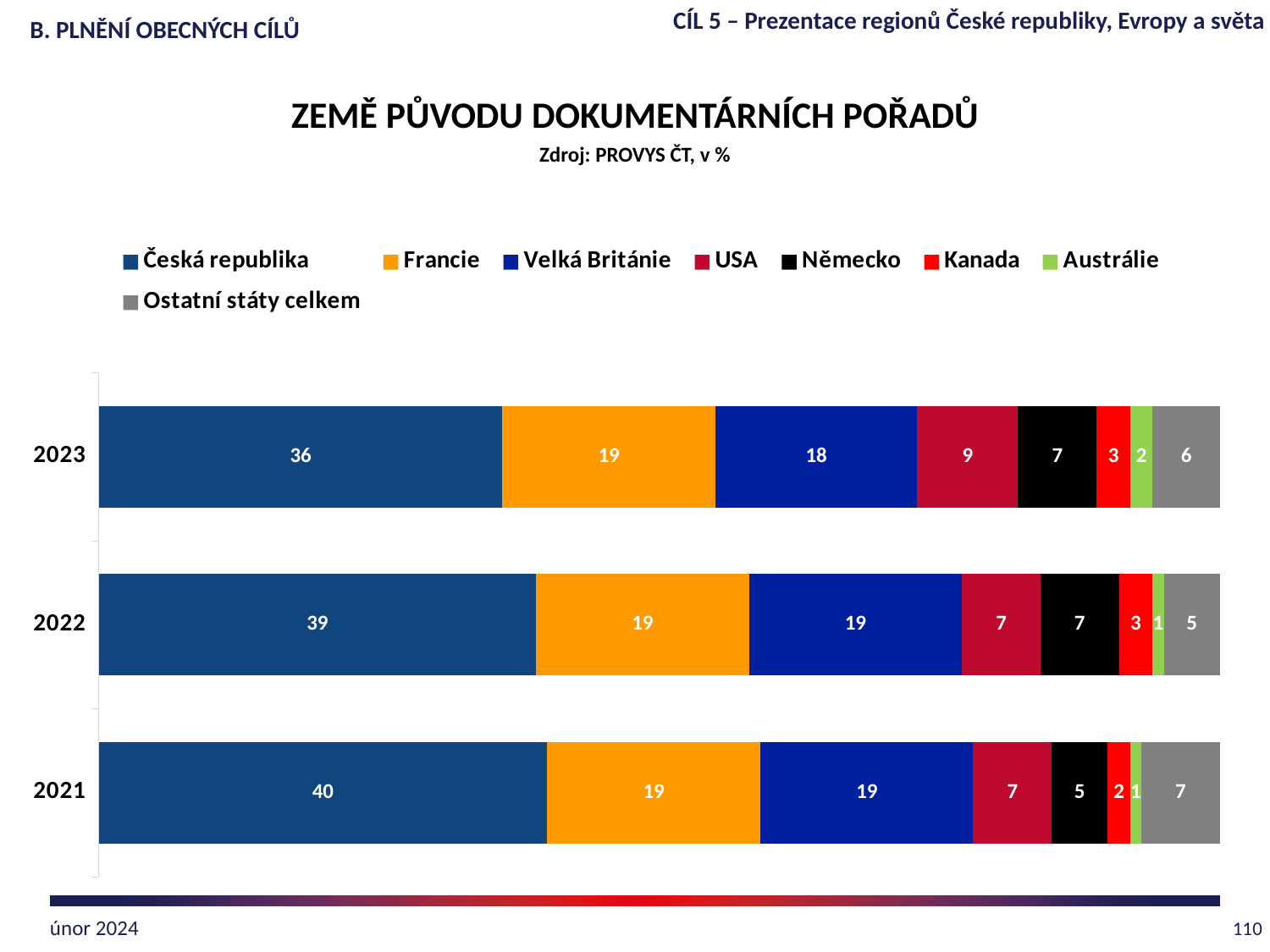
What type of chart is shown on the slide? Stacked bar chart Which is larger in 2023: the value for Francie or the value for Velká Británie? Francie What is the value for Ostatní státy celkem in 2022? 5 In which year is the value for Česká republika the highest? 2021 What is the value for Česká republika in 2023? 36 What is the total of the stacked bar for 2022? 100 How many years (categories) are shown on the chart? 3 What is the value for USA in 2023? 9 How many series does the legend list? 8 What is the difference between the Česká republika values in 2021 and 2023? 4 What is the value for Německo in 2021? 5 In which year is the value for Austrálie the highest? 2023